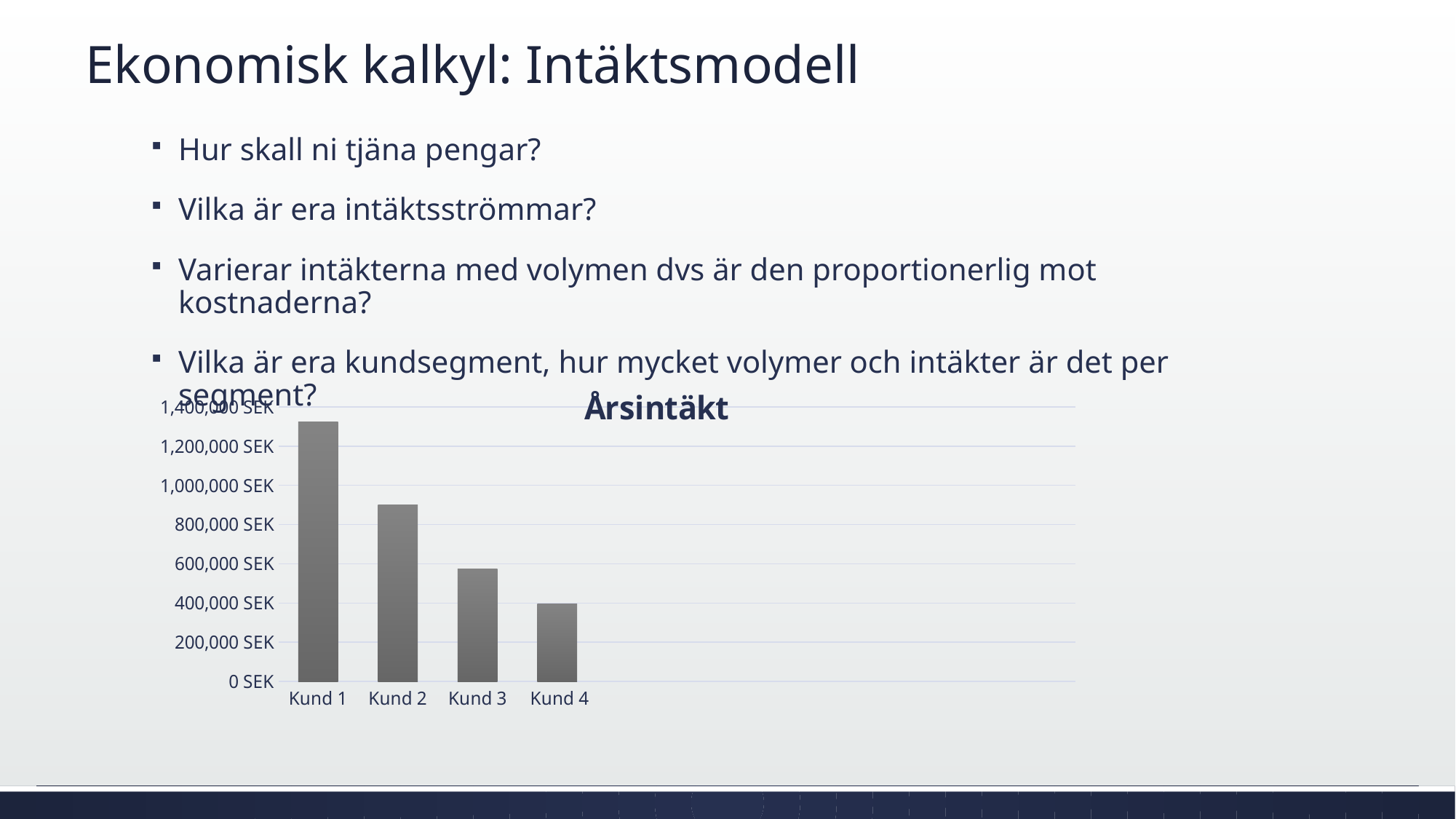
Is the value for Kund 1 greater or less than 1,200,000 SEK? greater What is the title of the chart? Årsintäkt Which customer has the highest annual revenue in the chart? Kund 1 Is the value for Kund 2 greater or less than 800,000 SEK? greater Do the values rise or fall from Kund 1 to Kund 4 along the x axis? fall Is the value for Kund 3 greater or less than 400,000 SEK? greater Which customer has the lowest annual revenue in the chart? Kund 4 What kind of chart is shown on the slide? bar chart What is the highest value shown on the y axis of the chart? 1,400,000 SEK Which is larger, the value for Kund 2 or the value for Kund 3? Kund 2 How many customer categories are shown on the x axis of the chart? 4